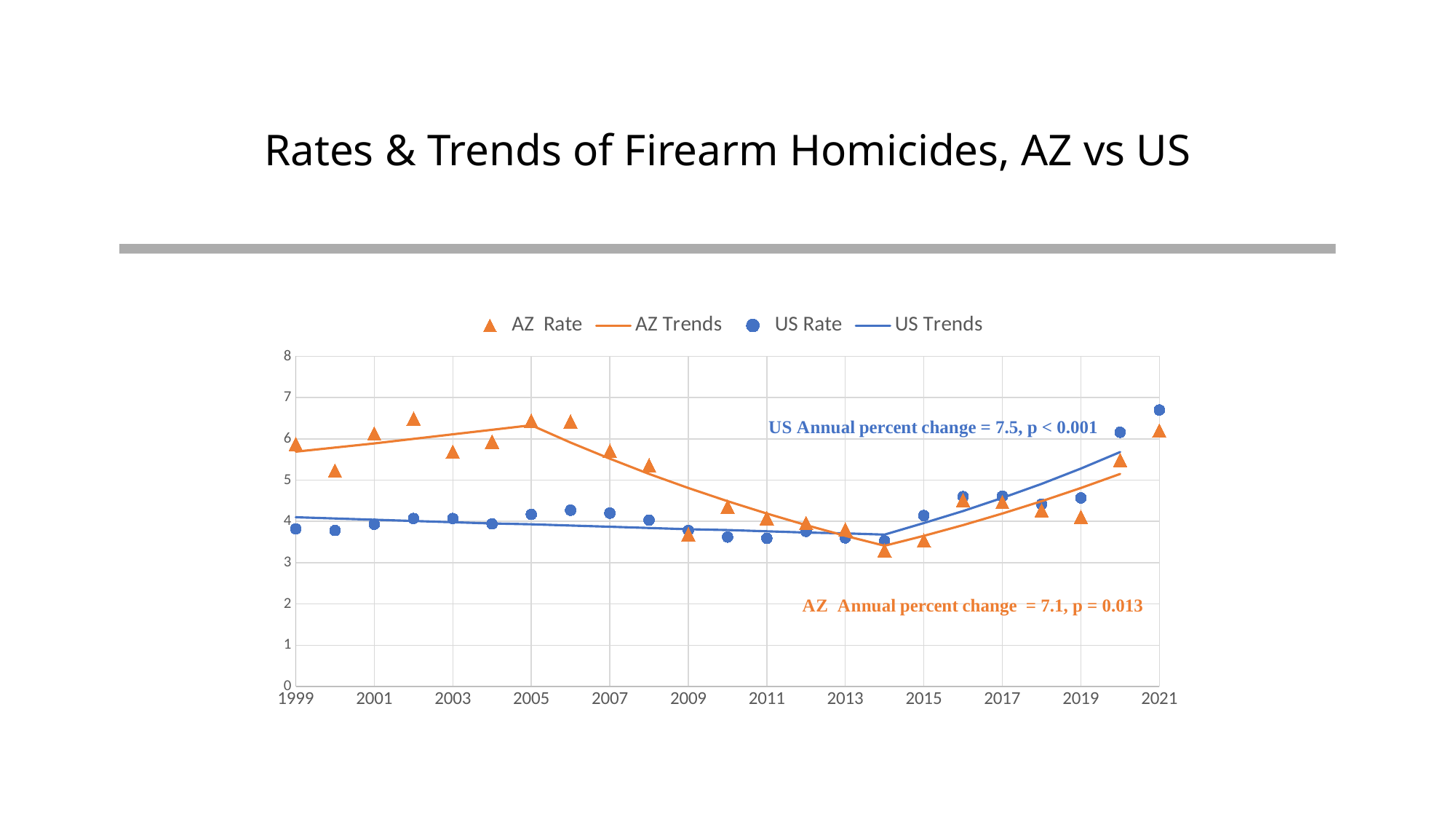
What is the title of the slide's chart? Rates & Trends of Firearm Homicides, AZ vs US What is the US annual percent change stated in the chart annotation? 7.5, p < 0.001 In 2021, which is higher, the AZ Rate or the US Rate? US Rate Is the US Rate value for 1999 greater or less than 4? less Is the US Rate value for 2021 greater or less than 6? greater Is the AZ Rate value for 2002 greater or less than 6? greater In which year is the US Rate highest? 2021 In which year is the AZ Rate lowest? 2014 Does the US Trends line rise or fall between 2014 and 2020? rise How many series does the legend list? 4 In 1999, which is higher, the AZ Rate or the US Rate? AZ Rate